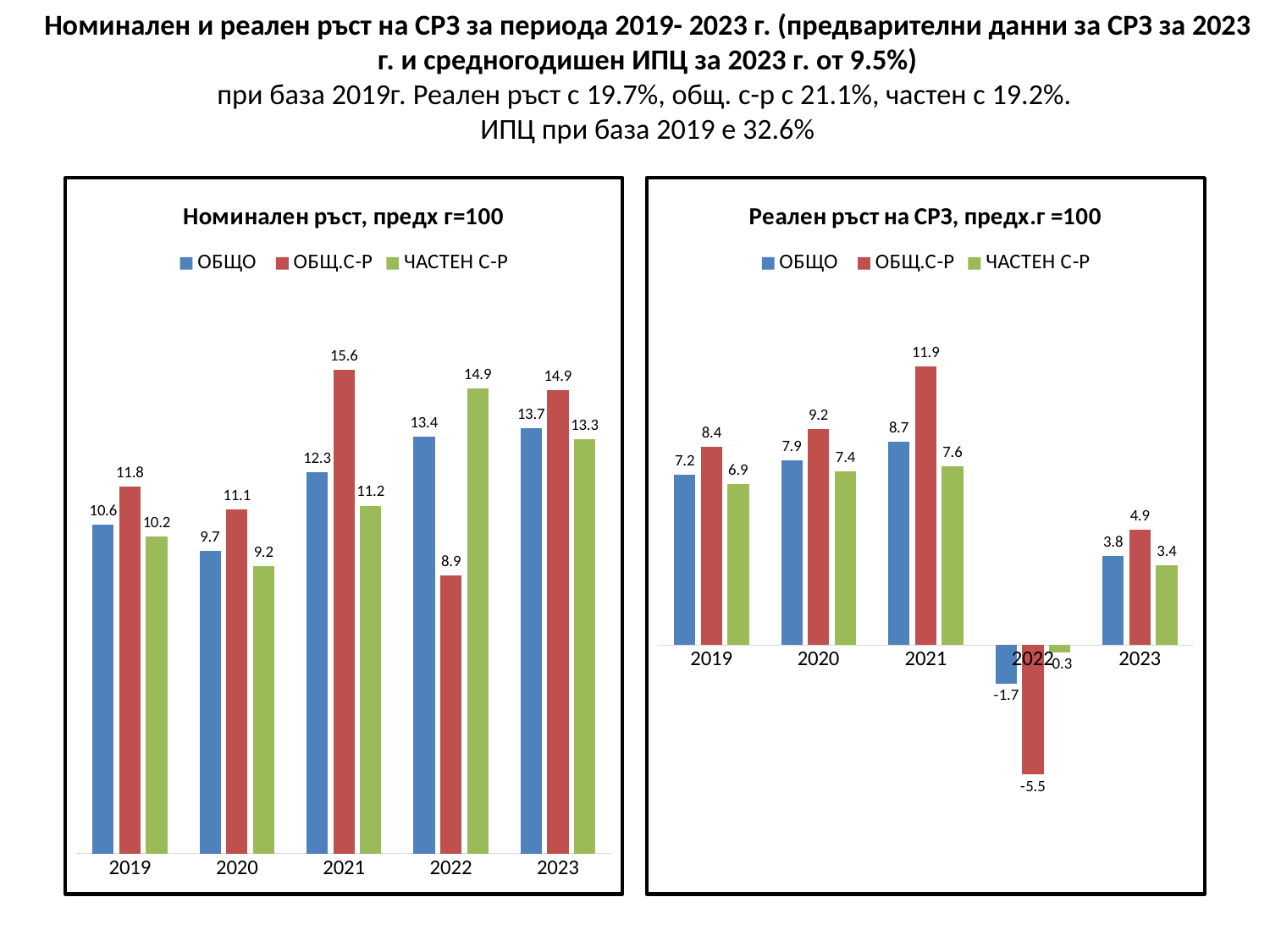
What type of chart is the left chart (Номинален ръст, предх г=100)? Bar chart In the right chart (Реален ръст на СРЗ, предх.г =100), which is larger in 2019: ОБЩО or ЧАСТЕН С-Р? ОБЩО In the right chart (Реален ръст на СРЗ, предх.г =100), what is the difference between ОБЩ.С-Р and ОБЩО in 2021? 3.2 In the right chart (Реален ръст на СРЗ, предх.г =100), what is the value for ОБЩО in 2023? 3.8 In the left chart (Номинален ръст, предх г=100), what is the value for ОБЩ.С-Р in 2021? 15.6 How many years are shown on the x axis of the right chart (Реален ръст на СРЗ, предх.г =100)? 5 In the right chart (Реален ръст на СРЗ, предх.г =100), what is the value for ОБЩ.С-Р in 2022? -5.5 In the left chart (Номинален ръст, предх г=100), which year has the lowest value for ОБЩО? 2020 In the left chart (Номинален ръст, предх г=100), what is the difference between ОБЩ.С-Р and ЧАСТЕН С-Р in 2022? 6.0 In the right chart (Реален ръст на СРЗ, предх.г =100), which year has the highest value for ОБЩ.С-Р? 2021 In the left chart (Номинален ръст, предх г=100), what is the value for ЧАСТЕН С-Р in 2022? 14.9 In the left chart (Номинален ръст, предх г=100), how many series does the legend list? 3